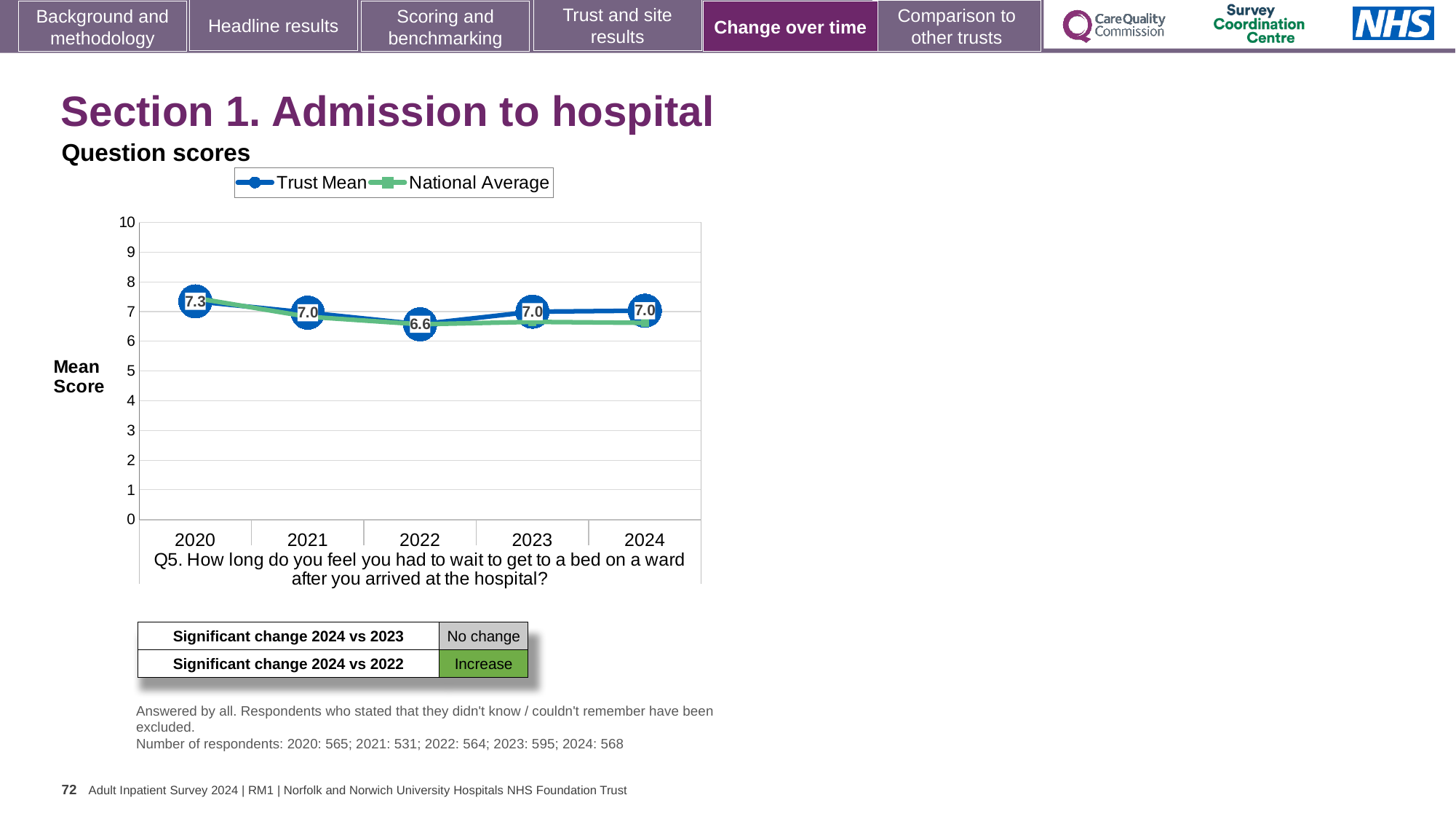
How many series does the legend list? 2 Which is larger, the Trust Mean score in 2021 or in 2022? 2021 How many years are plotted on the x axis? 5 What is the difference between the Trust Mean score in 2020 and in 2022? 0.7 What kind of chart is shown on the slide? Line chart Is the National Average value for 2020 greater or less than 5? greater Does the Trust Mean score rise or fall from 2020 to 2022? Fall What is the Trust Mean score for 2024? 7.0 What is the Trust Mean score for 2022? 6.6 What is the Trust Mean score for 2020? 7.3 In which year is the Trust Mean score lowest? 2022 In which year is the Trust Mean score highest? 2020